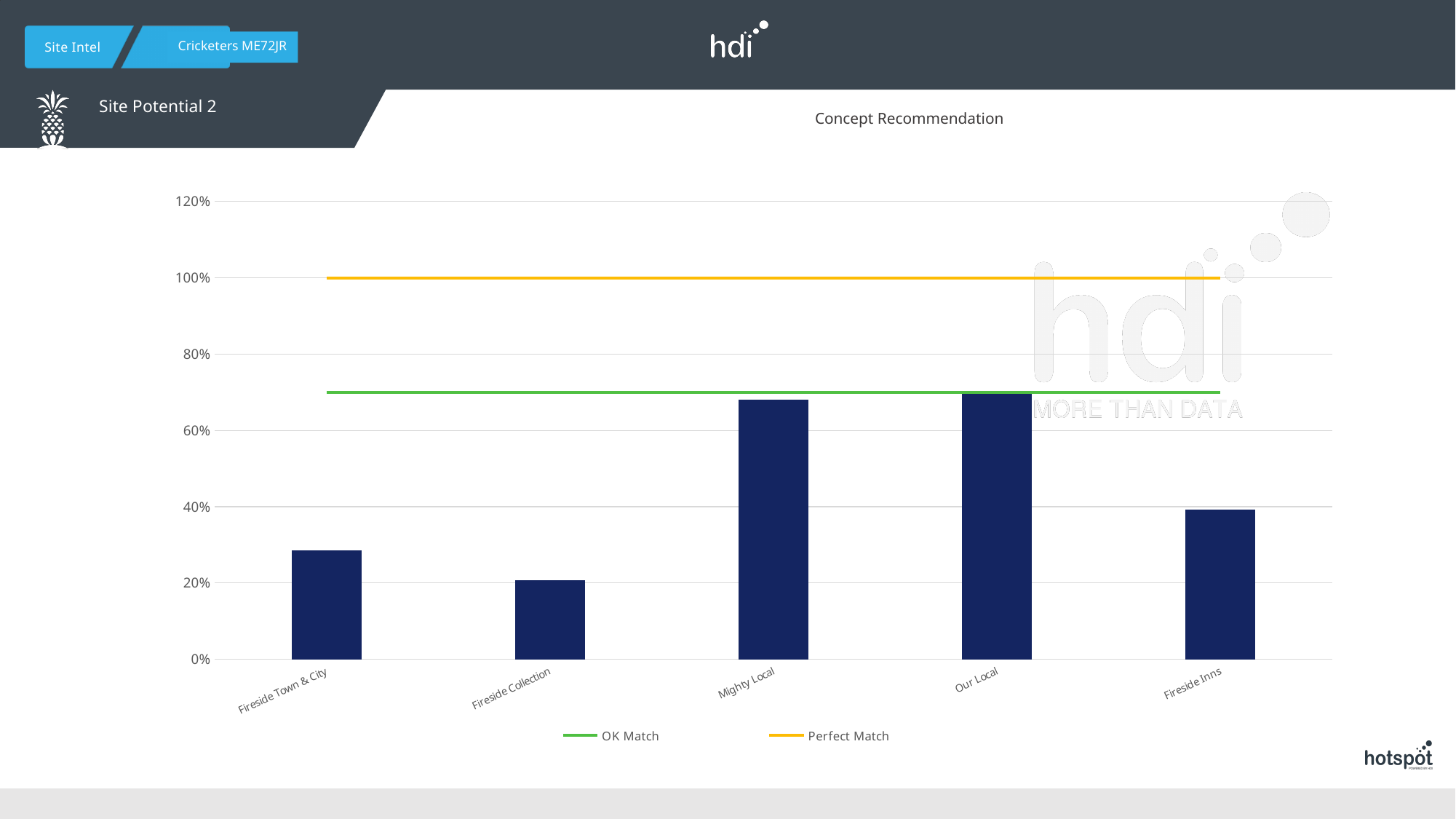
At what level on the y axis is the Perfect Match line drawn? 100% Which is larger, the value for Fireside Inns or the value for Fireside Town & City? Fireside Inns Which category has the lowest bar in the chart? Fireside Collection Which is larger, the value for Mighty Local or the value for Fireside Collection? Mighty Local How many categories are shown on the x axis of the chart? 5 Is the value for Fireside Inns greater or less than 20%? greater What kind of chart is shown on the slide? bar chart What is the title of the chart? Concept Recommendation How many entries does the chart's legend list? 2 Is the value for Fireside Town & City greater or less than 40%? less Is the value for Our Local greater or less than 60%? greater